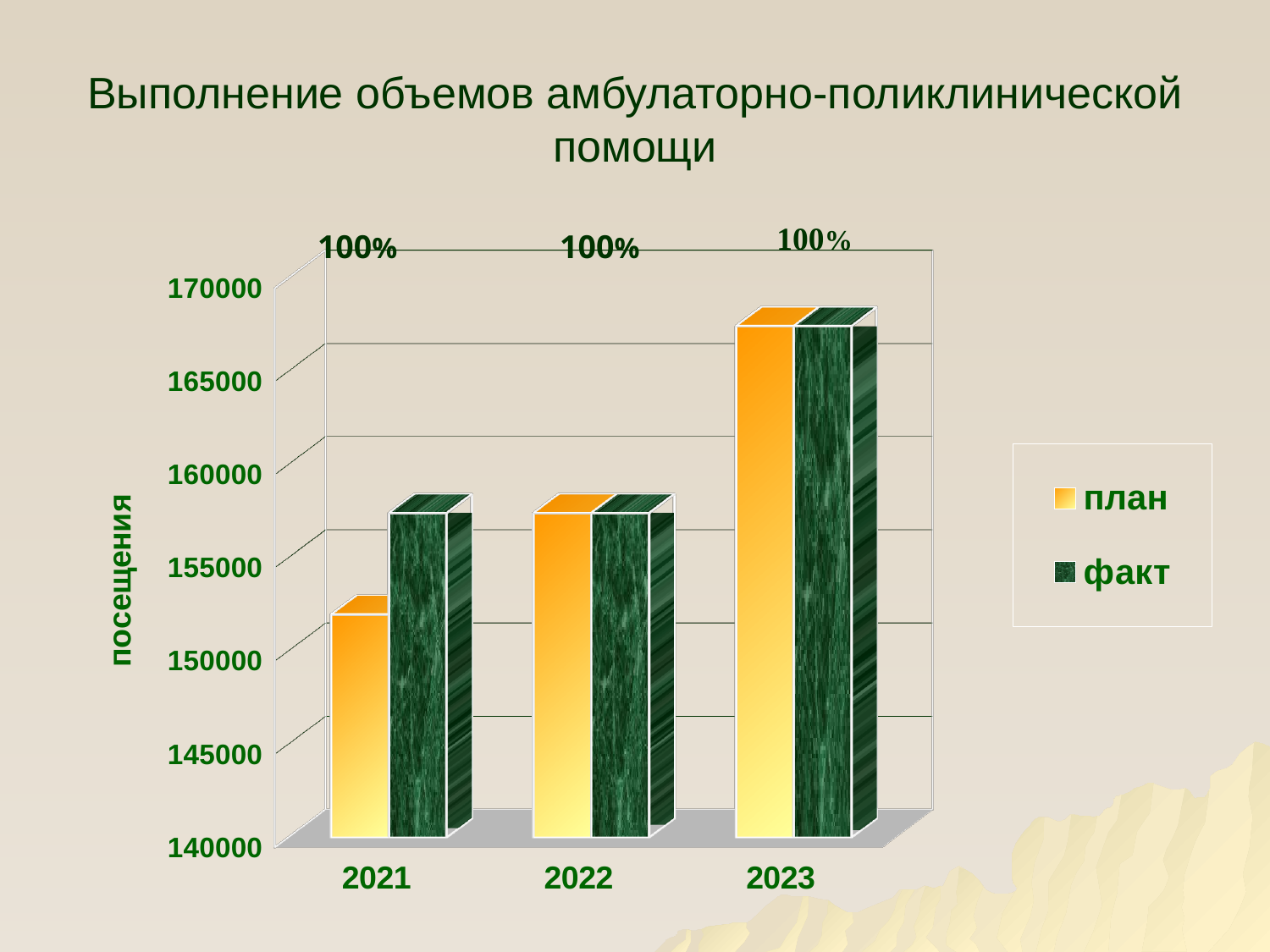
What kind of chart is shown on the slide? bar chart In 2021, which is larger: план or факт? факт Is the value for факт in 2021 greater or less than 155000? greater How many series does the legend list? 2 Which year has the highest value for план? 2023 Is the value for план in 2021 greater or less than 155000? less How many years are shown on the x axis? 3 Which year has the highest value for факт? 2023 Which year has the lowest value for план? 2021 Is the value for план in 2023 greater or less than 165000? greater What is the title of the vertical axis? посещения Does the value for план rise or fall from 2021 to 2023? rise